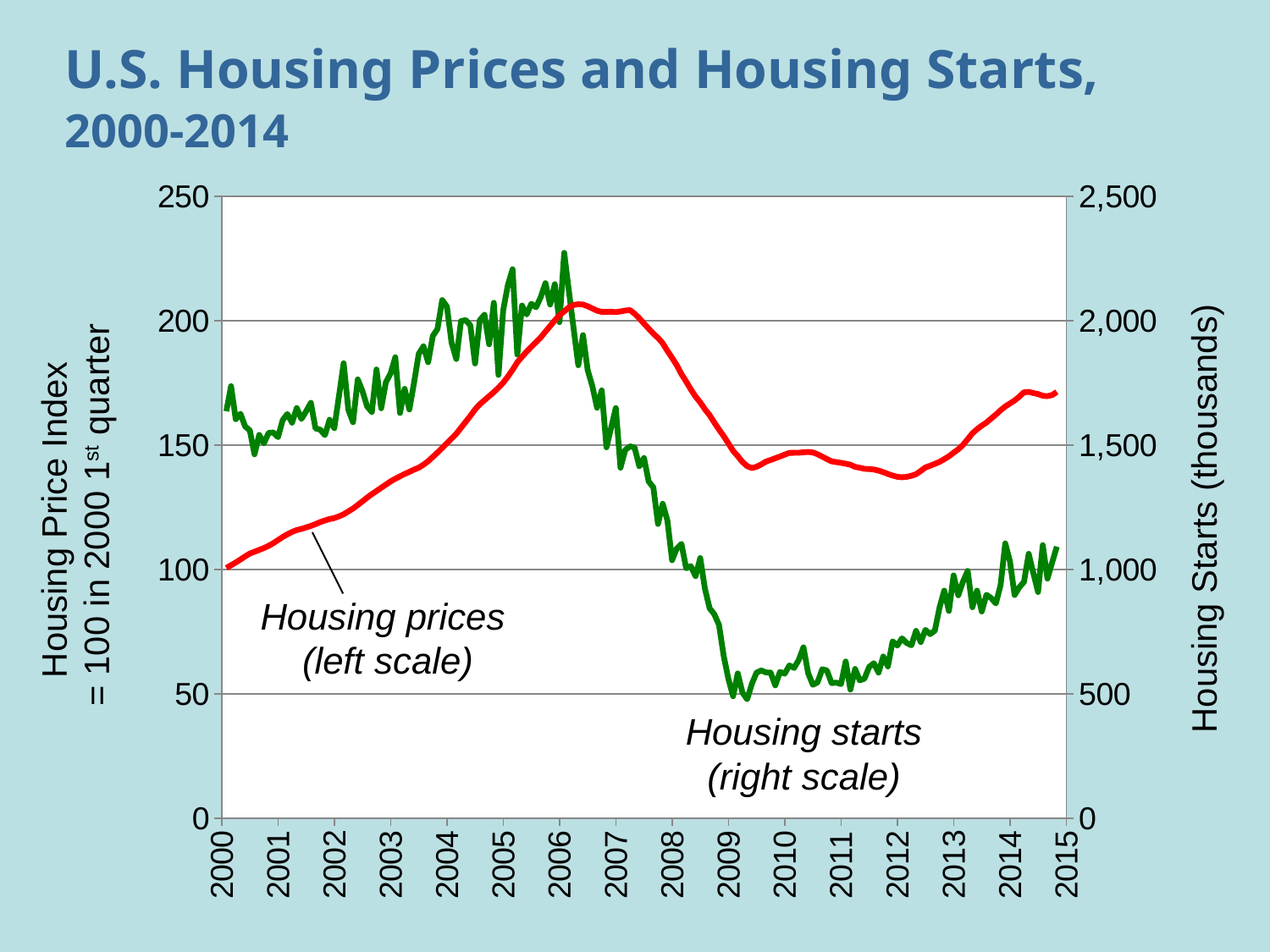
Which series is plotted against the right scale? Housing starts Is the peak value of housing prices around 2006 greater or less than 200? greater What is the Housing Price Index value in the first quarter of 2000? 100 Is the housing starts value at the start of 2000 greater or less than 1,500? greater How many data series are plotted on the chart? 2 What kind of chart is shown on the slide? Line chart Is the lowest value of housing starts around 2009 greater or less than 1,000? less Do housing starts rise or fall between 2006 and 2009? fall Do housing prices rise or fall between 2000 and 2006? rise What is the label of the right vertical axis? Housing Starts (thousands)